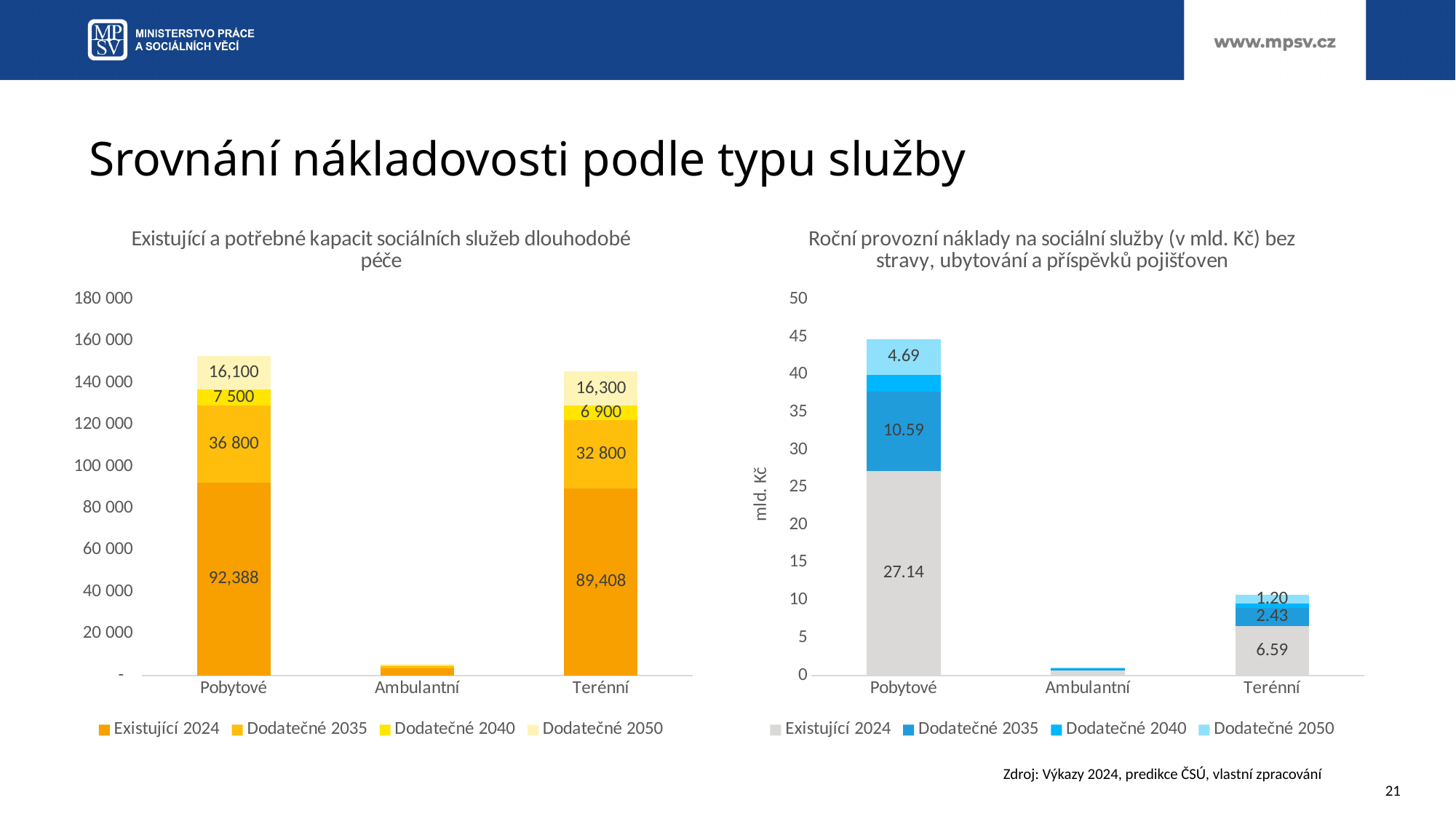
In the left chart, what is the difference between the Existující 2024 values for Pobytové and Terénní? 2,980 In the right chart, is the total value for Ambulantní greater or less than 5? less In the left chart, what is the Dodatečné 2035 value for Pobytové? 36 800 How many series does the legend of the right chart list? 4 In the right chart, what is the difference between the Existující 2024 values for Pobytové and Terénní? 20.55 In the left chart, which category has the lowest total capacity? Ambulantní What type of chart is the left chart? Stacked bar chart In the right chart, what is the Dodatečné 2035 value for Terénní? 2.43 In the left chart, is the total value for Ambulantní greater or less than 20 000? less In the left chart, what is the Dodatečné 2050 value for Terénní? 16,300 In the right chart (Roční provozní náklady na sociální služby), what is the Existující 2024 value for Pobytové? 27.14 In the left chart (Existující a potřebné kapacit sociálních služeb dlouhodobé péče), what is the Existující 2024 value for Pobytové? 92,388